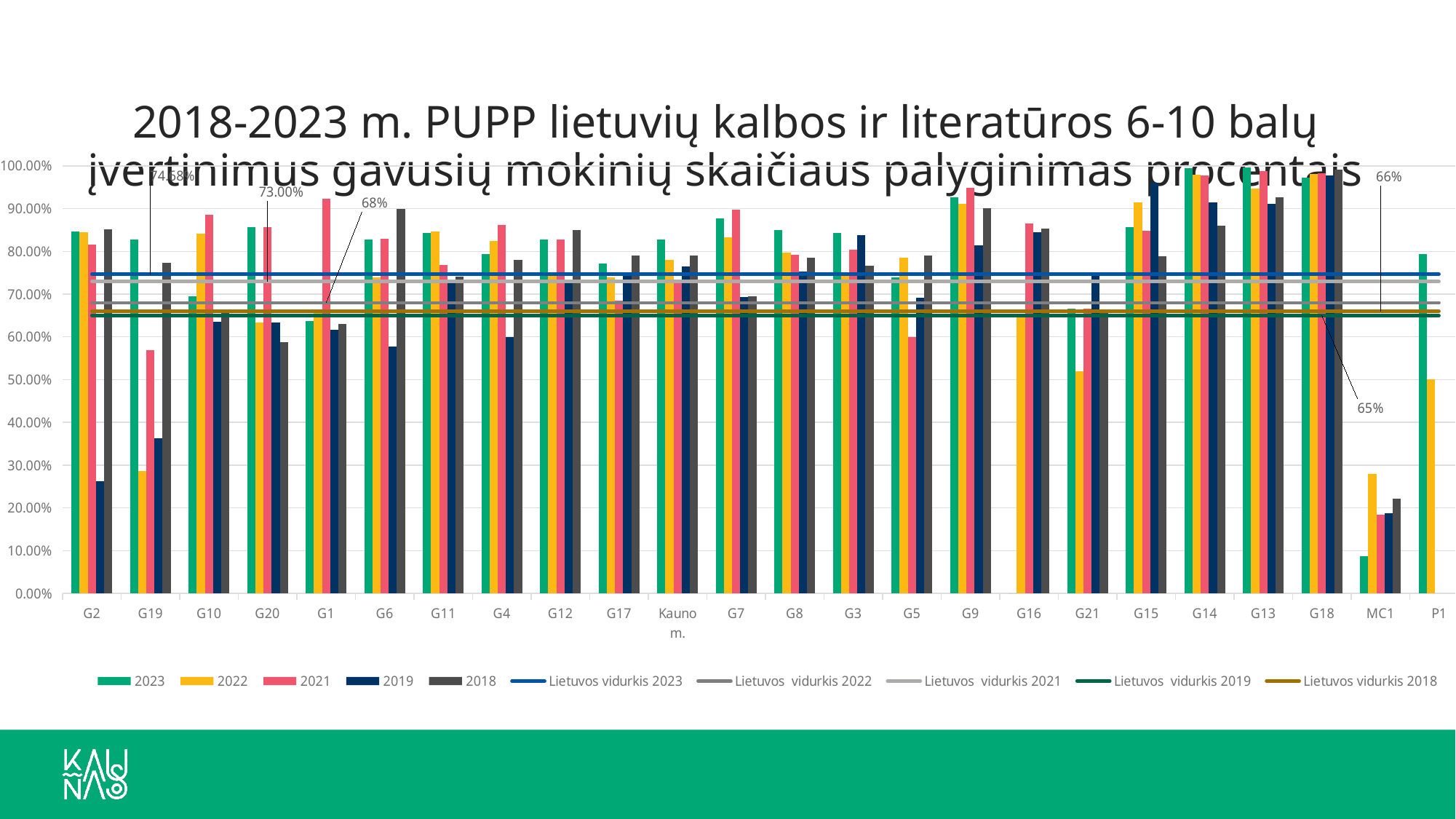
Is the value for G14 in the 2023 series greater or less than 90%? greater Which series is shown in green bars according to the legend? 2023 What value is labelled for the Lietuvos vidurkis 2023 line? 74.68% What value is labelled for the Lietuvos vidurkis 2021 line? 73.00% How many categories are shown along the x axis? 24 For G10, which is larger: the 2021 value or the 2019 value? 2021 Is the value for G19 in the 2019 series greater or less than 40%? less Is the value for MC1 in the 2023 series greater or less than 20%? less What kind of chart is shown on the slide? combination bar and line chart What value is labelled for the Lietuvos vidurkis 2022 line? 68% How many series does the legend list? 10